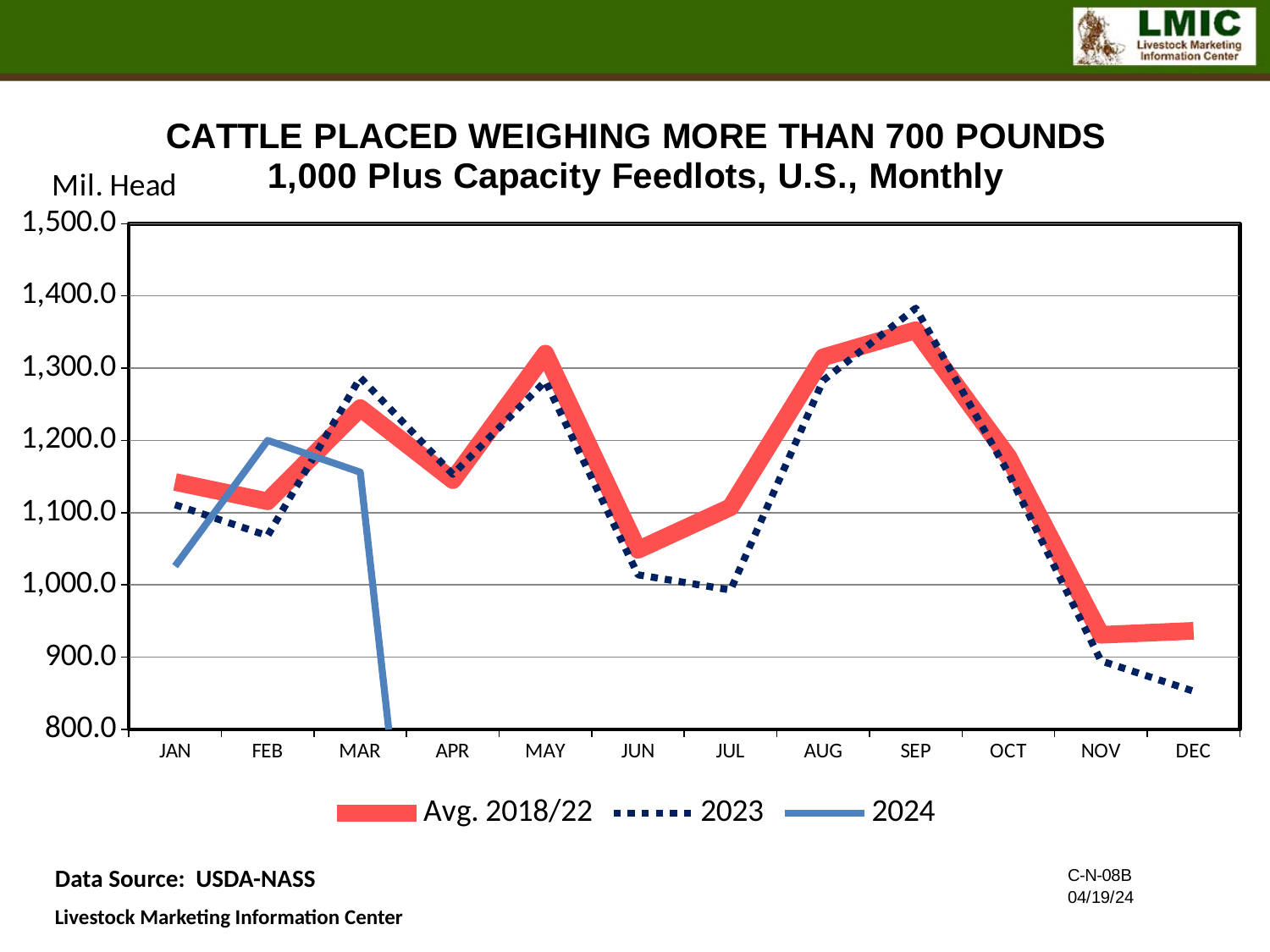
In which month does the Avg. 2018/22 series reach its highest value? SEP How many series does the legend list? 3 What kind of chart is shown on the slide? line chart Does the 2023 series rise or fall from SEP to DEC? fall Is the 2023 value for DEC greater or less than 900.0? less Is the 2023 value for SEP greater or less than 1,300.0? greater Is the 2024 value for JAN greater or less than 1,100.0? less In FEB, which series has the larger value, 2024 or Avg. 2018/22? 2024 How many months are shown along the x axis? 12 In which month does the 2023 series reach its highest value? SEP In which month does the 2023 series reach its lowest value? DEC What unit is shown on the y axis of the chart? Mil. Head